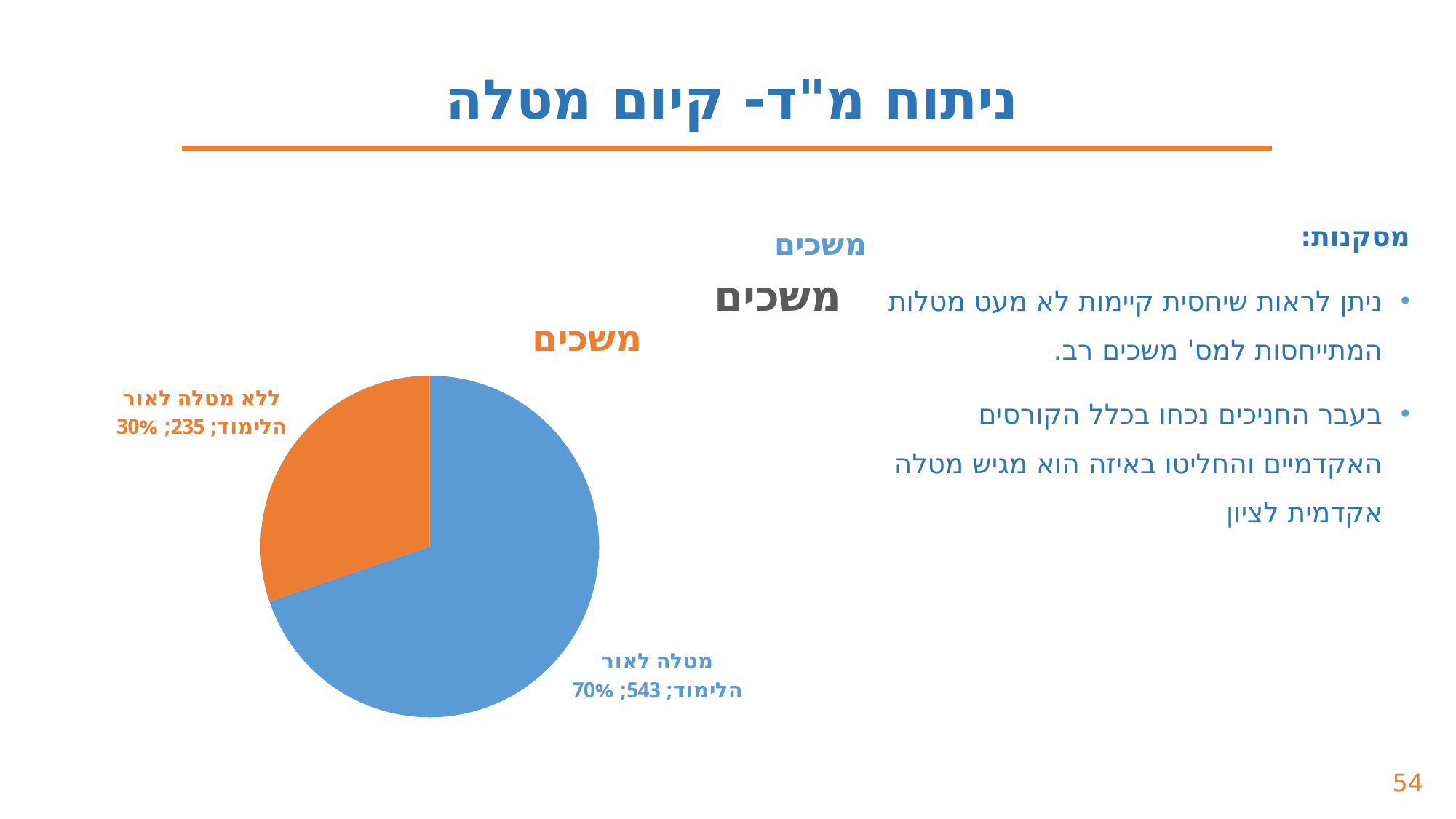
What is the title of the pie chart? משכים Which slice of the pie chart is the smallest? ללא מטלה לאור הלימוד What colour is the slice for ללא מטלה לאור הלימוד? orange What is the value for מטלה לאור הלימוד in the pie chart? 543 What share of the pie does מטלה לאור הלימוד represent? 70% Which slice of the pie chart is the largest? מטלה לאור הלימוד What is the difference between the values for מטלה לאור הלימוד and ללא מטלה לאור הלימוד? 308 What share of the pie does ללא מטלה לאור הלימוד represent? 30% How many slices does the pie chart have? 2 Which is larger: the value for מטלה לאור הלימוד or for ללא מטלה לאור הלימוד? מטלה לאור הלימוד What is the value for ללא מטלה לאור הלימוד in the pie chart? 235 What kind of chart is shown on the slide? pie chart